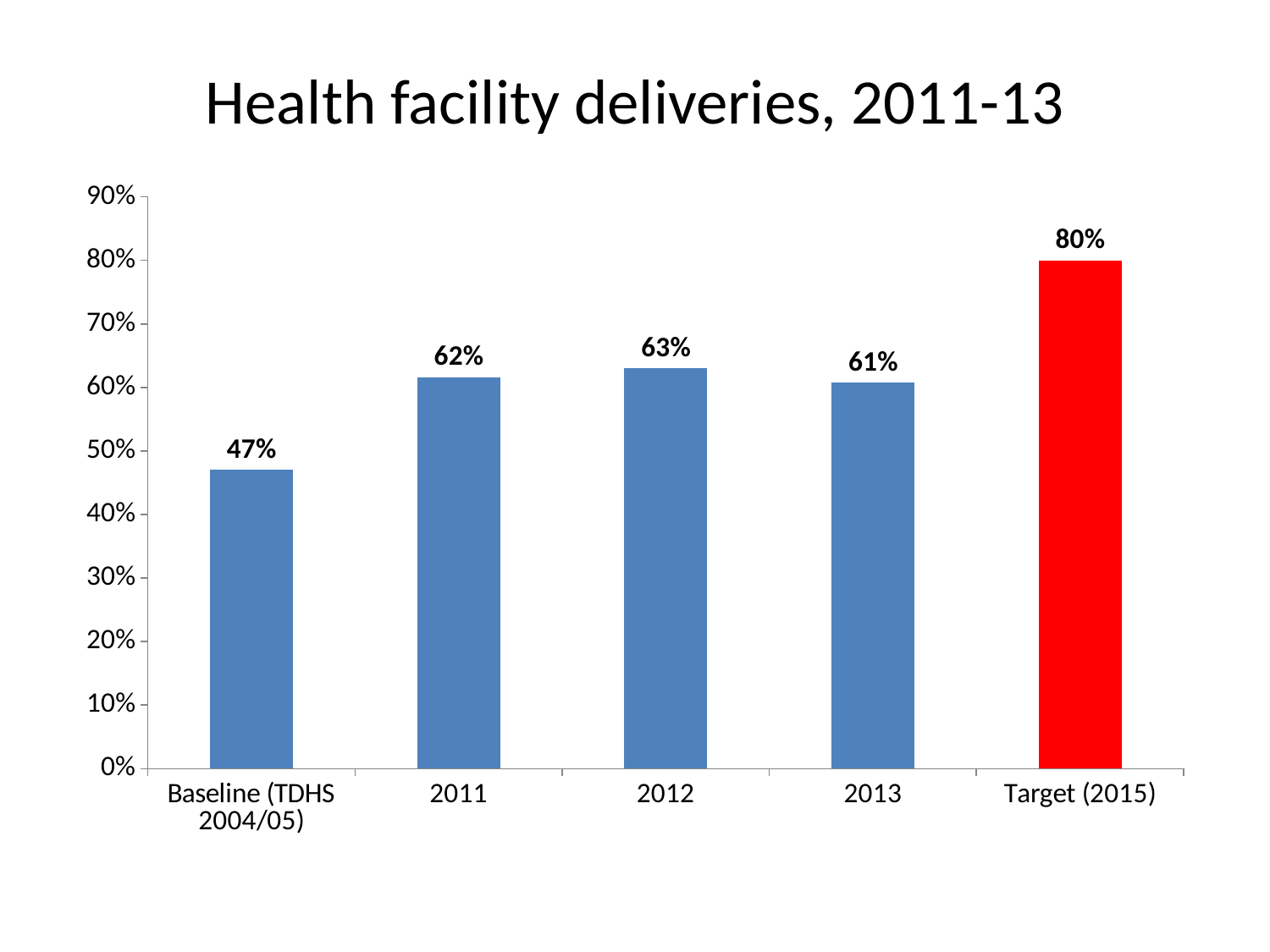
What kind of chart is shown on the slide? Bar chart Which category has the lowest value? Baseline (TDHS 2004/05) Which is larger, the value for 2011 or the value for Target (2015)? Target (2015) What is the difference between the 2011 value and the Baseline (TDHS 2004/05) value? 15% What is the value for the Baseline (TDHS 2004/05)? 47% What is the value for Target (2015)? 80% Which category has the highest value? Target (2015) How many bars are shown in the chart? 5 What is the title of the chart? Health facility deliveries, 2011-13 What is the value for 2013? 61% What is the difference between the Target (2015) value and the 2013 value? 19% What is the value for 2012? 63%